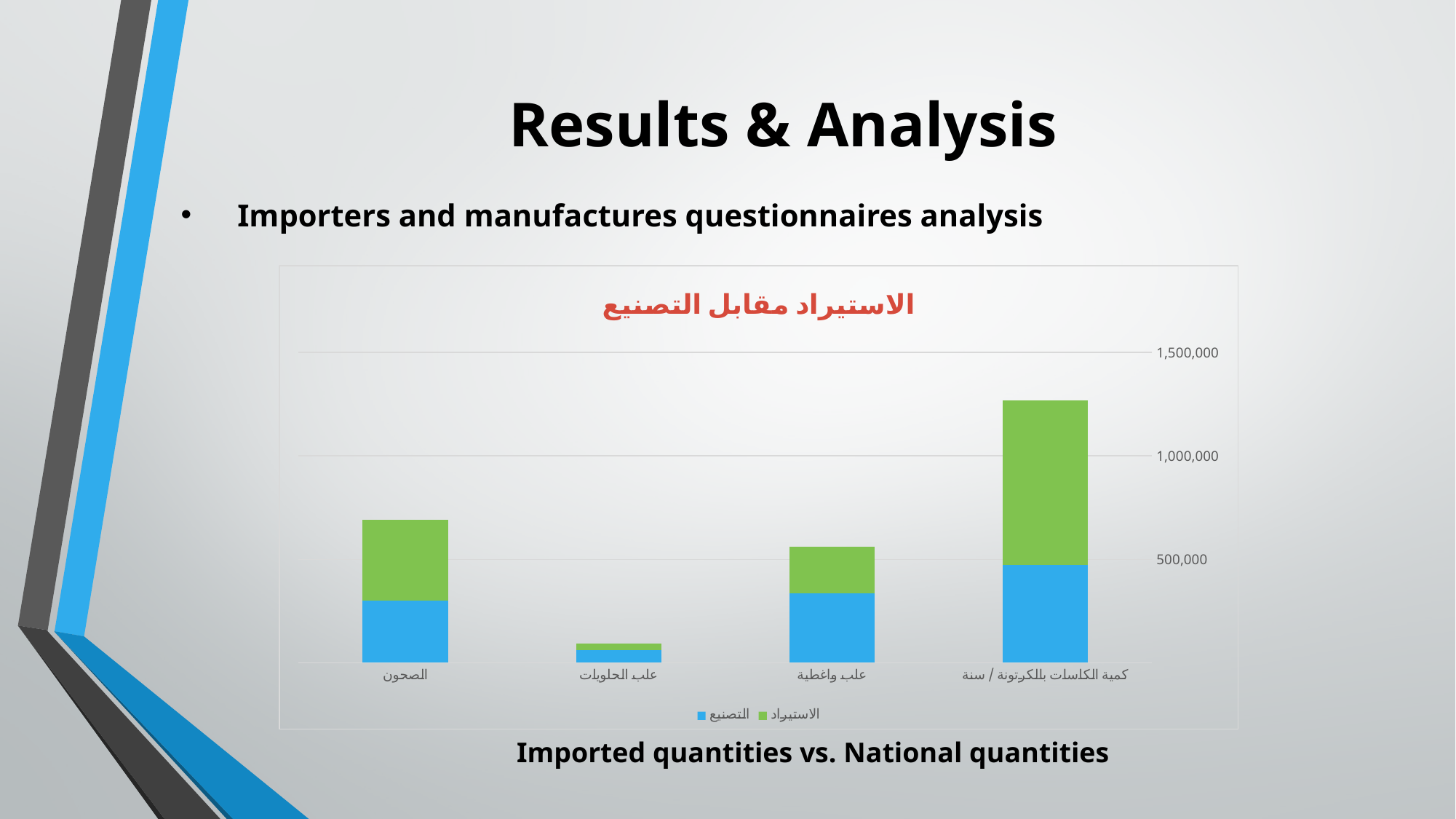
Which colour represents the التصنيع series in the chart? Blue What is the title of the chart? الاستيراد مقابل التصنيع In the الصحون bar, which series has the larger segment, التصنيع or الاستيراد? الاستيراد Which category has the tallest stacked bar in the chart? كمية الكاسات بالكرتونة / سنة What kind of chart is shown on the slide? Stacked bar chart How many categories are shown on the x axis of the chart? 4 How many series does the chart's legend list? 2 Which category has the shortest stacked bar in the chart? علب الحلويات Is the total stacked value for علب الحلويات greater or less than 500,000? less Which has the larger total stacked bar, الصحون or علب واغطية? الصحون Is the total stacked value for الصحون greater or less than 1,000,000? less